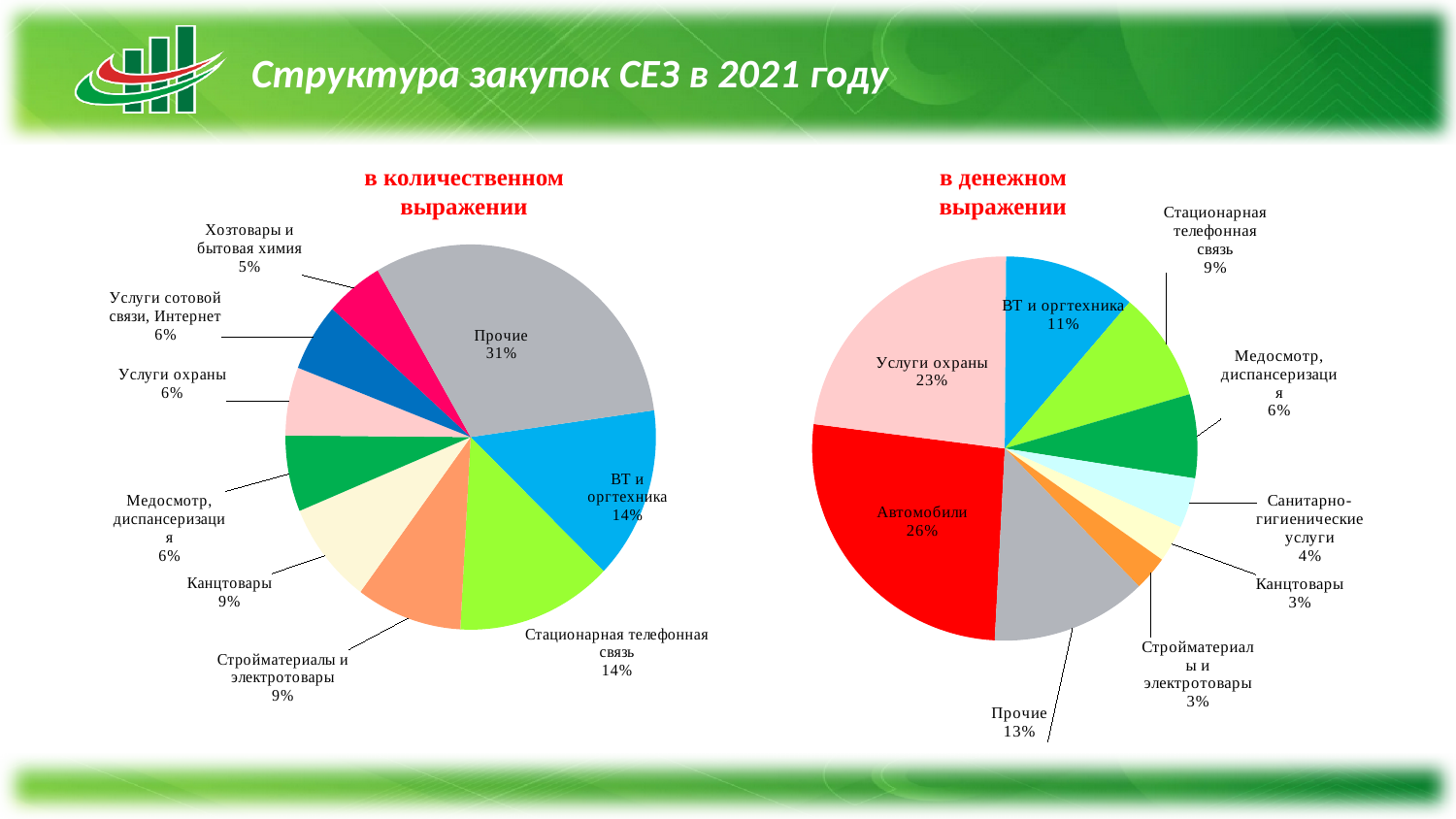
In the left pie chart (в количественном выражении), which category has the smallest share? Хозтовары и бытовая химия In the left pie chart (в количественном выражении), how many slices are there? 9 In the left pie chart (в количественном выражении), which category has the largest share? Прочие In the right pie chart (в денежном выражении), what is the difference between the shares of Автомобили and Прочие? 13 percentage points In the left pie chart (в количественном выражении), what is the difference between the shares of Прочие and ВТ и оргтехника? 17 percentage points In the right pie chart (в денежном выражении), what share does Услуги охраны have? 23% What type of charts are shown on the slide? Pie charts In the left pie chart (в количественном выражении), what share does Прочие have? 31% In the right pie chart (в денежном выражении), which category has the largest share? Автомобили In the left pie chart (в количественном выражении), what share does Канцтовары have? 9% In the right pie chart (в денежном выражении), which is larger: ВТ и оргтехника or Стационарная телефонная связь? ВТ и оргтехника In the right pie chart (в денежном выражении), what share does Автомобили have? 26%